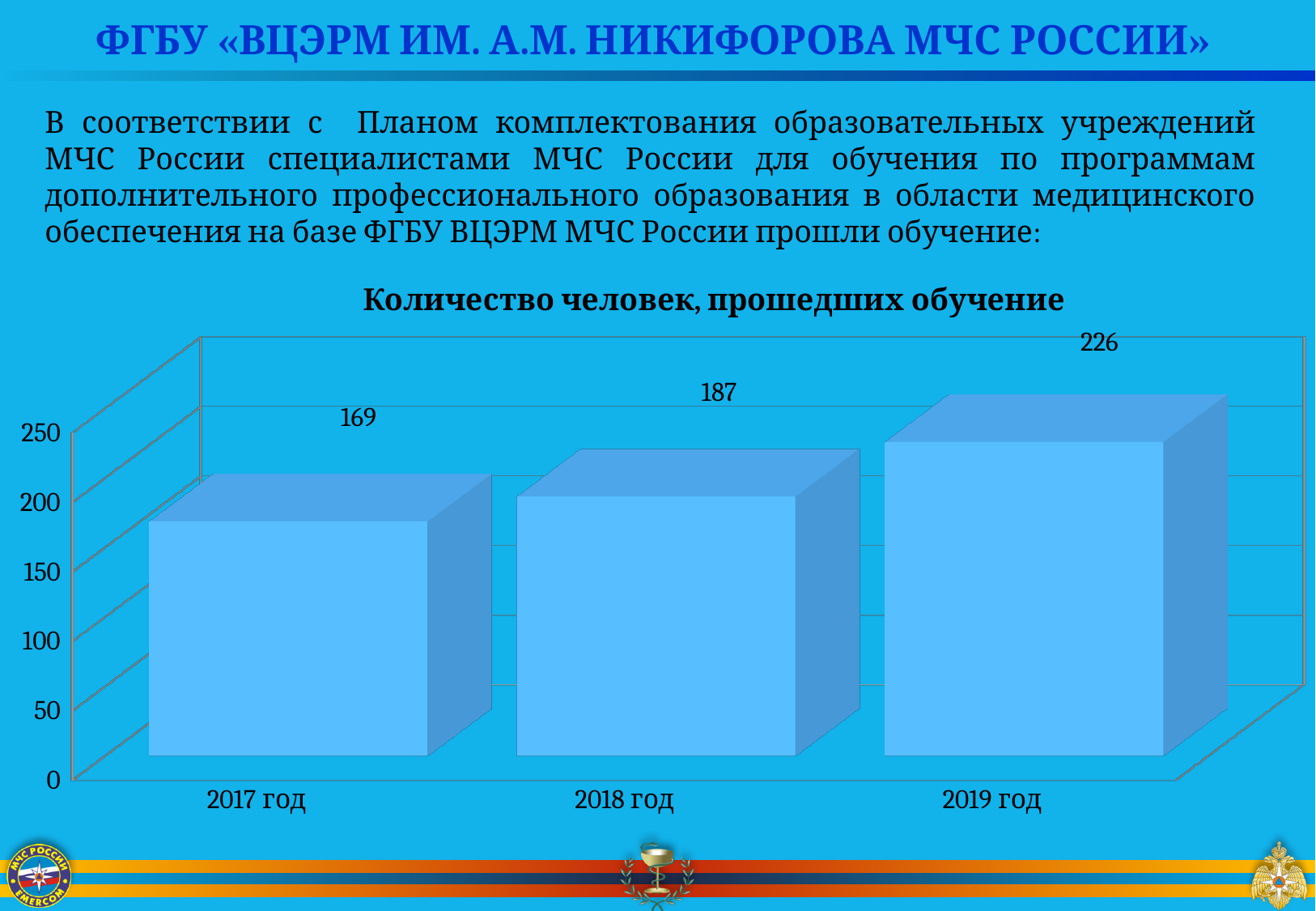
Which is larger, the value for 2018 год or the value for 2019 год? 2019 год What is the value for 2019 год? 226 What is the difference between the values for 2019 год and 2017 год? 57 What is the difference between the values for 2018 год and 2017 год? 18 Do the values rise or fall from 2017 год to 2019 год? rise Which year has the lowest value? 2017 год What is the value for 2017 год? 169 What is the value for 2018 год? 187 What kind of chart is shown on the slide? bar chart Which year has the highest value? 2019 год How many categories are shown on the x axis? 3 Is the value for 2019 год greater or less than 200? greater